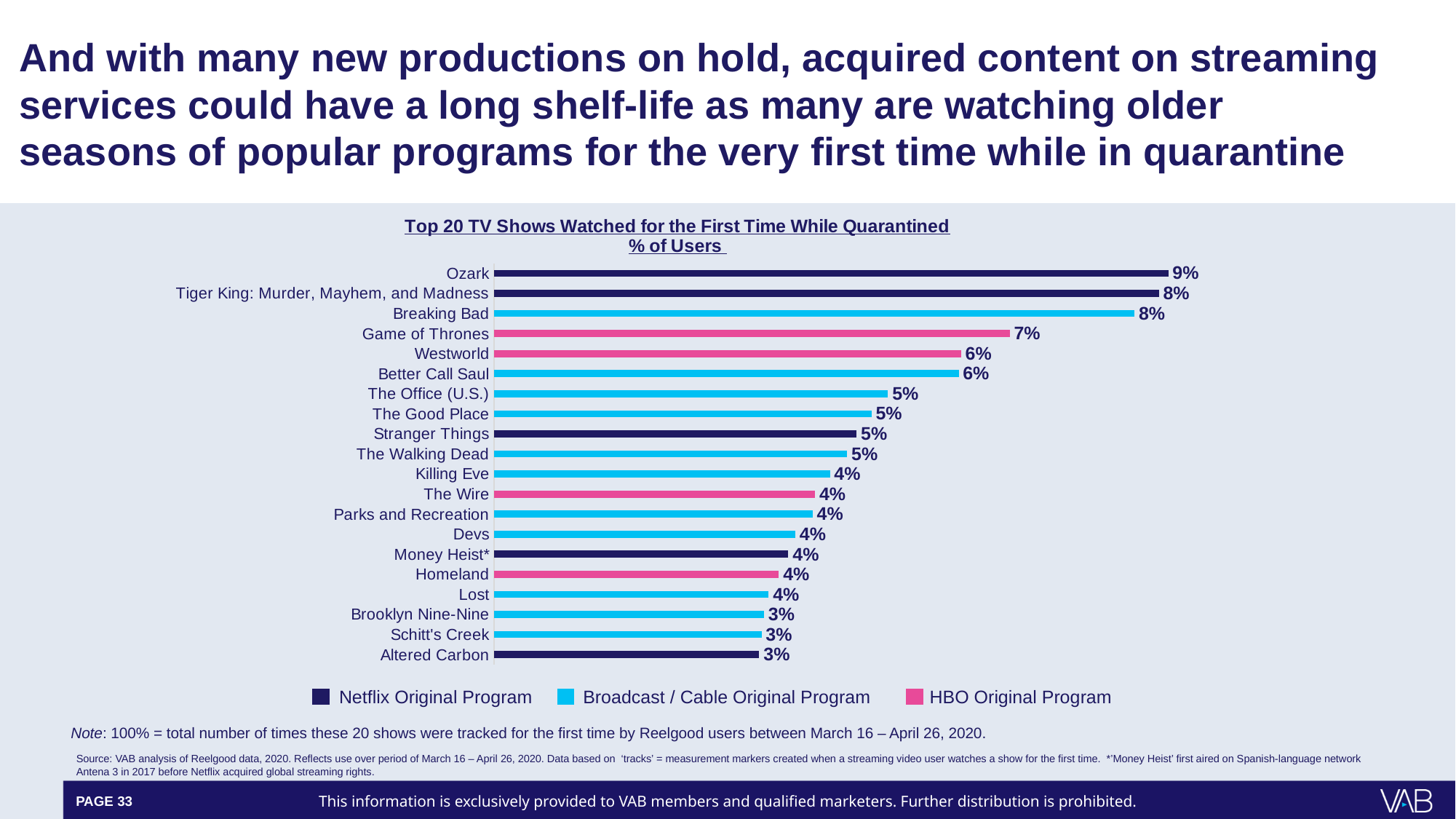
Which has a larger value, Ozark or Westworld? Ozark How many series does the legend list? 3 How many TV shows are listed in the chart? 20 What kind of chart is shown on the slide? Bar chart Which legend category is shown in pink? HBO Original Program What is the value shown for Game of Thrones? 7% Which has a larger value, Breaking Bad or Stranger Things? Breaking Bad What percentage of users watched Ozark for the first time while quarantined? 9% What is the value shown for Altered Carbon? 3% Which TV show has the highest percentage of users in the chart? Ozark What is the difference in percentage points between Ozark and Game of Thrones? 2 percentage points What is the value shown for Better Call Saul? 6%